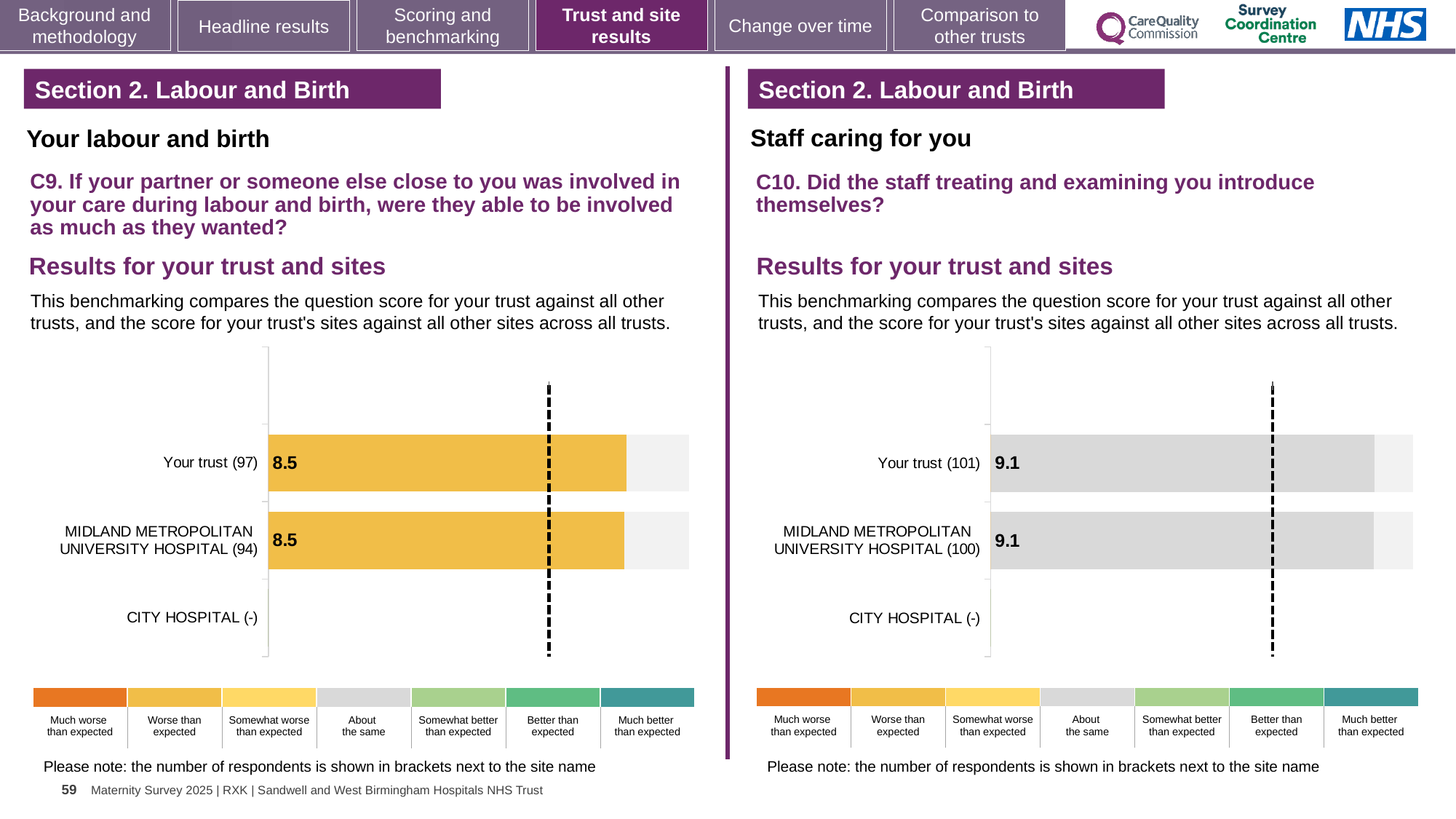
How many site/trust rows are listed in the C9 chart on the left? 3 How many site/trust rows are listed in the C10 chart on the right? 3 What kind of chart is used for the C9 results on the left? Bar chart In the C10 chart on the right, what is the difference between the score for Your trust (101) and the score for MIDLAND METROPOLITAN UNIVERSITY HOSPITAL (100)? 0.0 In the C9 chart on the left, what is the difference between the score for Your trust (97) and the score for MIDLAND METROPOLITAN UNIVERSITY HOSPITAL (94)? 0.0 In the C9 chart on the left, what is the score for Your trust (97)? 8.5 In the C10 chart on the right, which benchmark category does the grey colour of the bars correspond to in the legend? About the same In the C9 chart on the left, what is the score for MIDLAND METROPOLITAN UNIVERSITY HOSPITAL (94)? 8.5 In the C10 chart on the right, what is the score for MIDLAND METROPOLITAN UNIVERSITY HOSPITAL (100)? 9.1 In the C10 chart on the right, what is the score for Your trust (101)? 9.1 In the C9 chart on the left, which row has no bar plotted? CITY HOSPITAL (-) In the C9 chart on the left, which benchmark category does the colour of the bars correspond to in the legend? Worse than expected